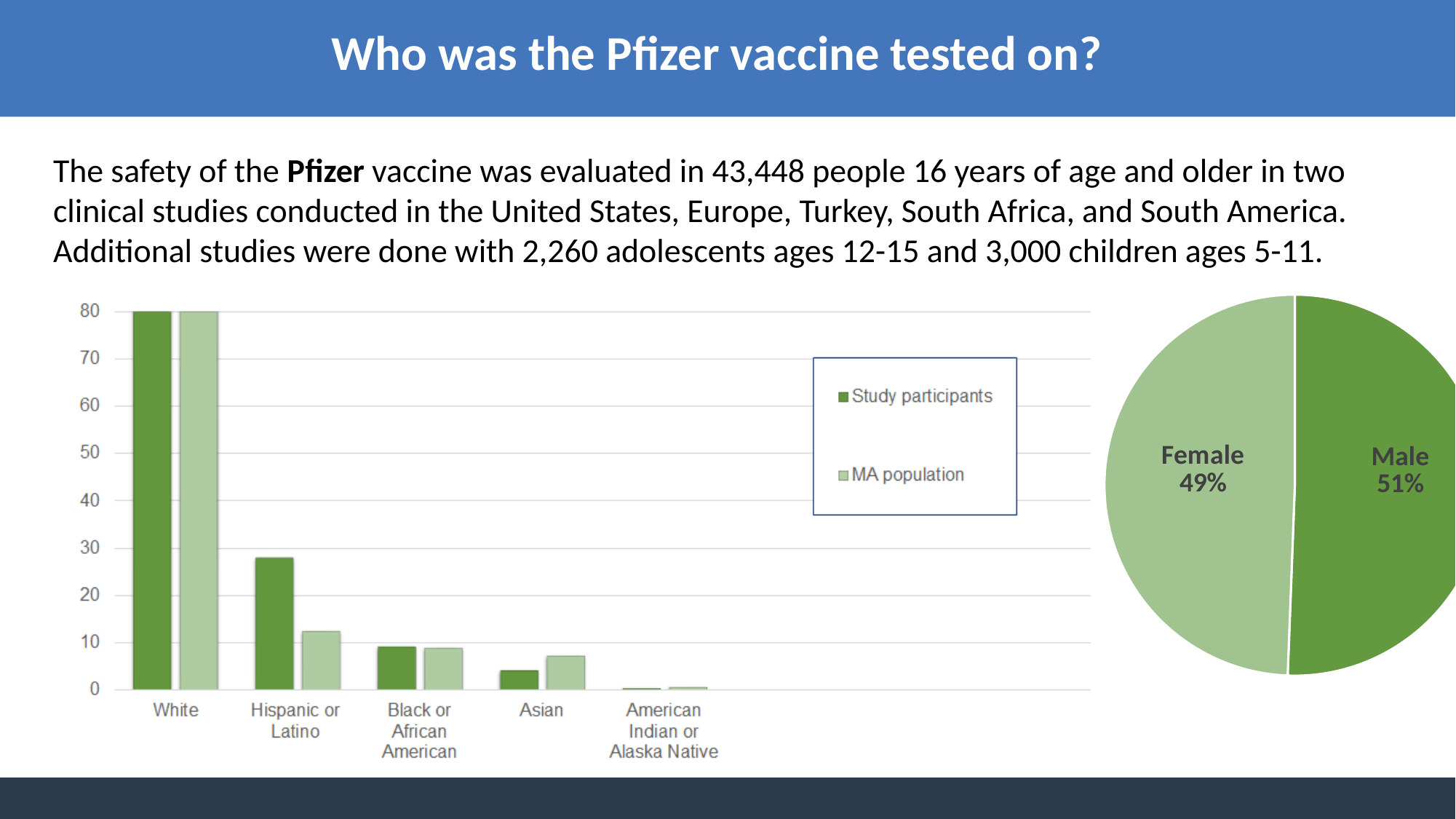
How many series does the legend of the left bar chart list? 2 What are the two series named in the legend of the left bar chart? Study participants and MA population How many categories are shown on the x axis of the left bar chart? 5 In the left bar chart, which category has the highest value for Study participants? White In the left bar chart, is the Study participants value for Hispanic or Latino greater or less than 20? greater In the pie chart on the right, which slice is larger, Female or Male? Male In the left bar chart, for Asian, which is larger: Study participants or MA population? MA population In the left bar chart, for Hispanic or Latino, which is larger: Study participants or MA population? Study participants In the left bar chart, is the MA population value for Hispanic or Latino greater or less than 20? less In the pie chart on the right, what share is Male? 51% What kind of chart is the chart on the left side of the slide? bar chart In the left bar chart, which category has the lowest value for Study participants? American Indian or Alaska Native